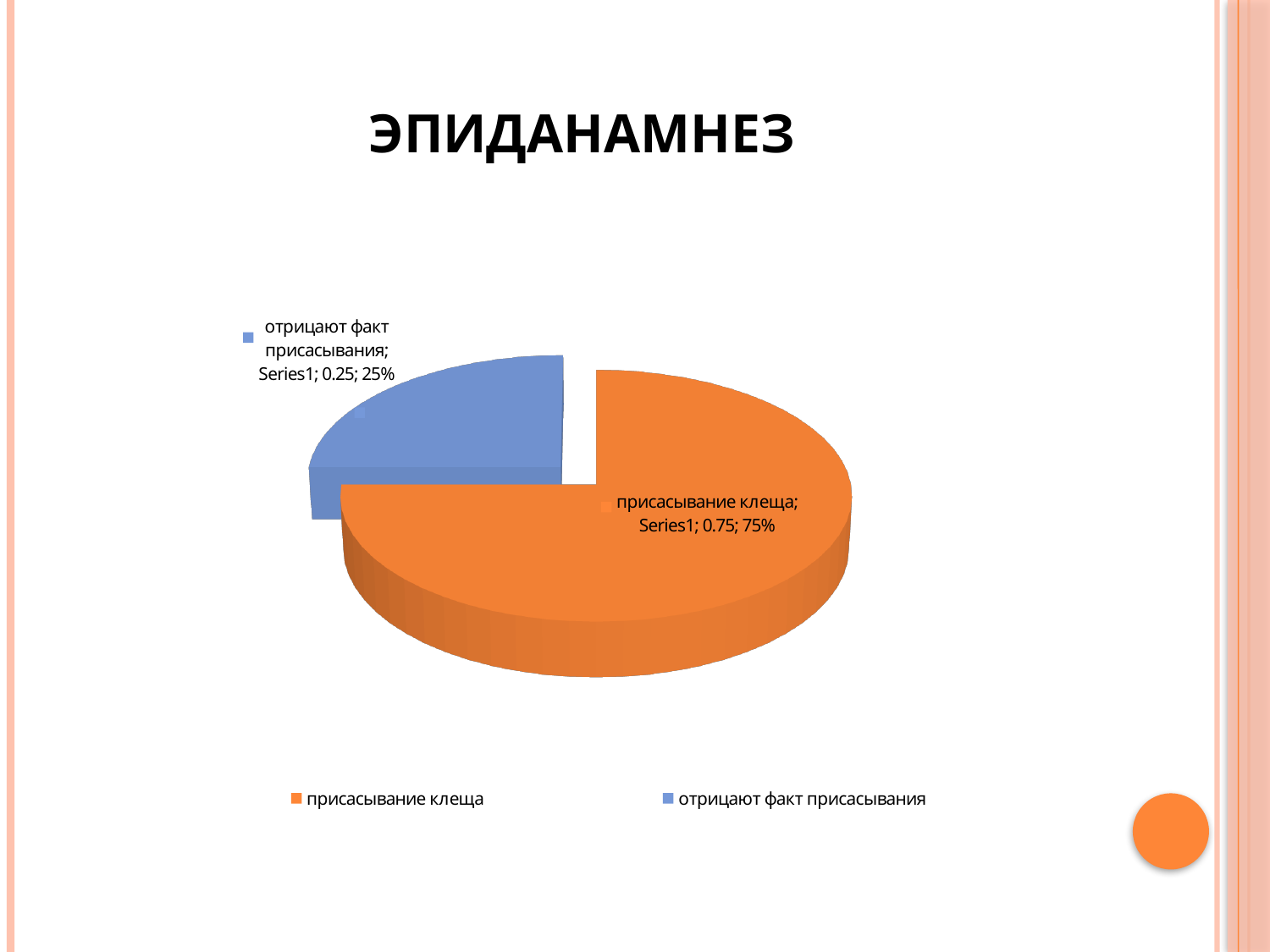
What is the title of the slide containing the chart? ЭПИДАНАМНЕЗ What percentage share does the slice "отрицают факт присасывания" have? 25% What kind of chart is shown on the slide? pie chart What is the difference in percentage points between "присасывание клеща" and "отрицают факт присасывания"? 50% Which is larger: "присасывание клеща" or "отрицают факт присасывания"? присасывание клеща How many slices does the pie chart have? 2 What percentage share does the slice "присасывание клеща" have? 75% What value is printed for "присасывание клеща"? 0.75 What value is printed for "отрицают факт присасывания"? 0.25 Which slice is the largest? присасывание клеща What colour is the slice for "отрицают факт присасывания"? blue Which slice is the smallest? отрицают факт присасывания